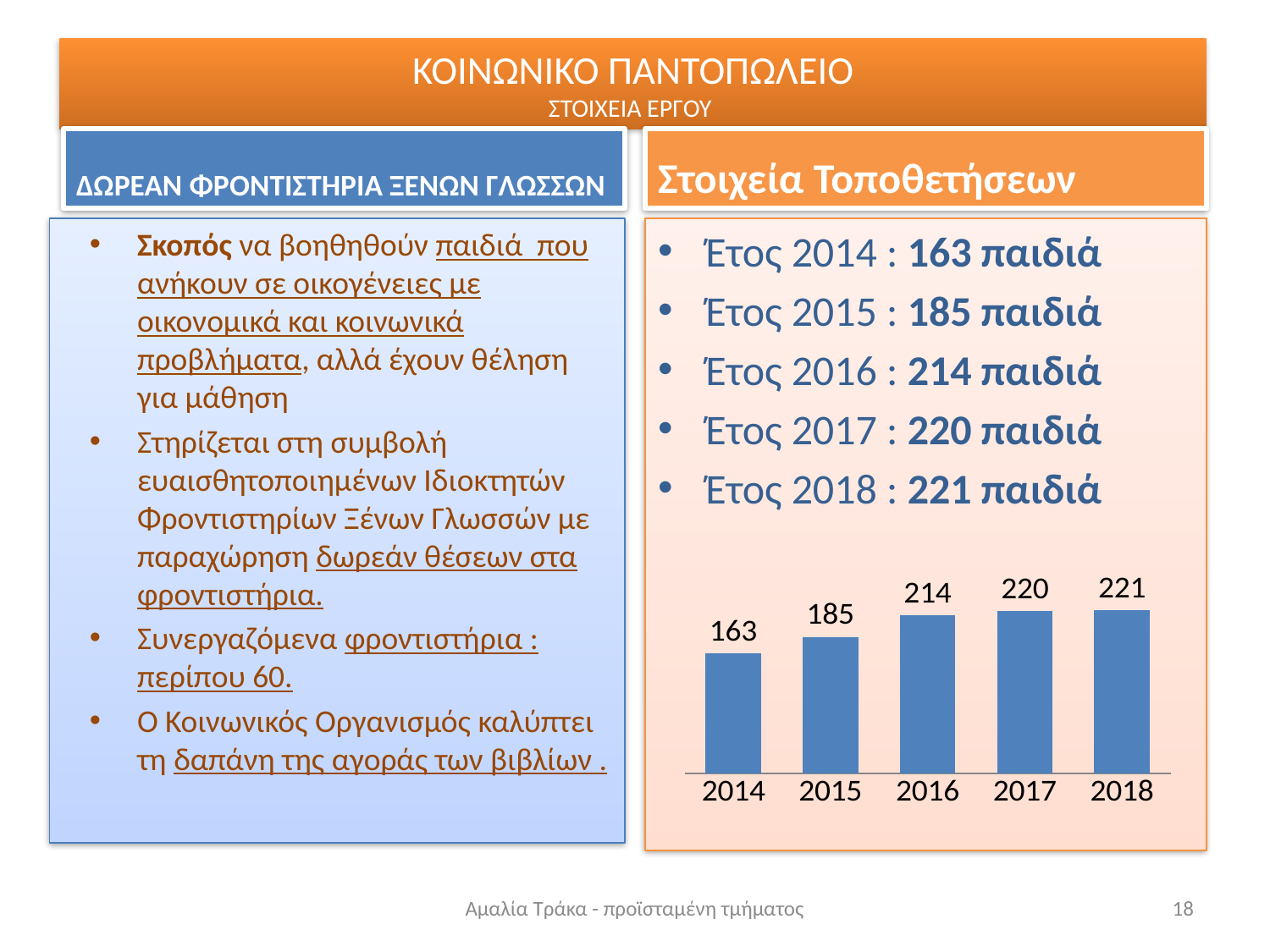
Which is larger in the bar chart, the value for 2015 or the value for 2016? 2016 What is the difference between the values for 2018 and 2014 in the bar chart? 58 What kind of chart is shown on the slide? bar chart How many bars are shown in the bar chart? 5 What is the value for 2016 in the bar chart? 214 Do the values in the bar chart rise or fall from 2014 to 2018? rise What is the difference between the values for 2016 and 2015 in the bar chart? 29 Which year has the highest value in the bar chart? 2018 What colour are the bars in the chart? blue What is the value for 2014 in the bar chart? 163 Which year has the lowest value in the bar chart? 2014 What is the value for 2018 in the bar chart? 221